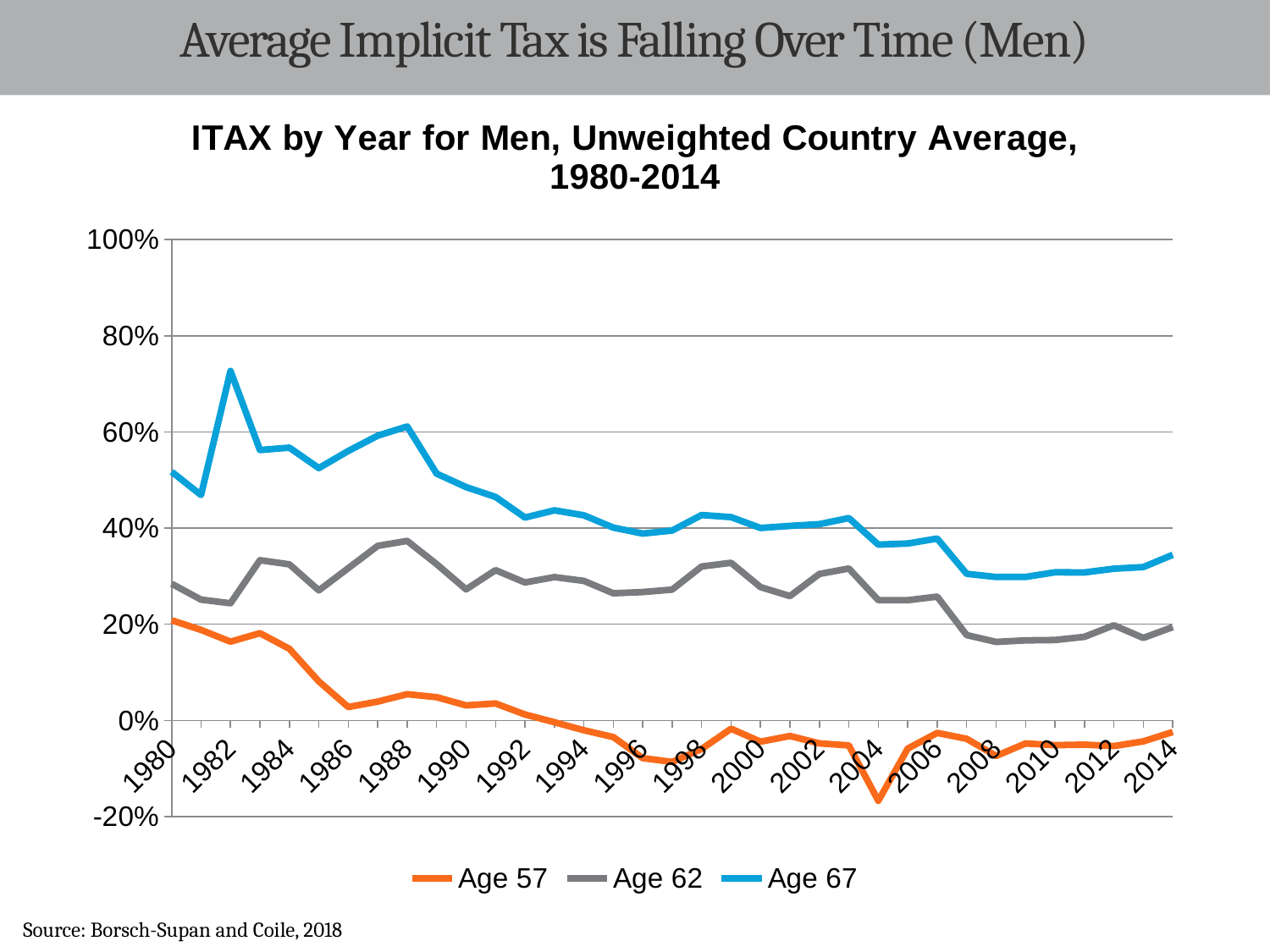
Which series has the highest values across the whole period? Age 67 In 1990, which is larger: the value for Age 67 or the value for Age 57? Age 67 What is the title of the chart? ITAX by Year for Men, Unweighted Country Average, 1980-2014 Is the value for Age 67 in 2014 greater or less than 40%? less Is the value for Age 67 in 1982 greater or less than 60%? greater How many series does the legend list? 3 What kind of chart is shown on the slide? line chart Does the Age 67 series generally rise or fall from 1980 to 2014? fall How many year labels are shown on the x axis? 18 Is the value for Age 62 in 2008 greater or less than 20%? less Which series has the lowest values across the whole period? Age 57